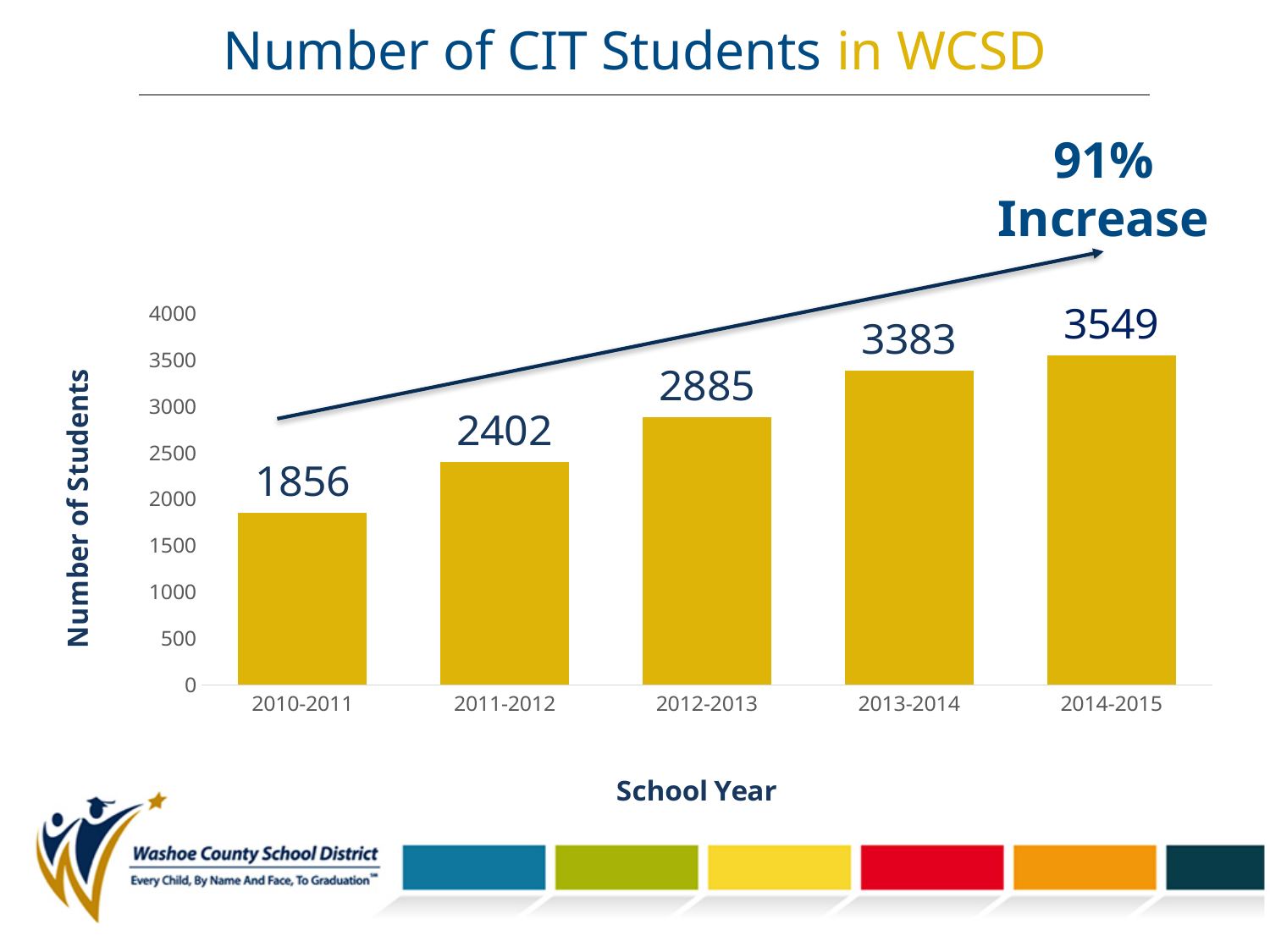
What is the value shown for 2014-2015? 3549 Which school year has the lowest number of CIT students? 2010-2011 What type of chart is shown on the slide? bar chart What is the difference in the number of CIT students between 2014-2015 and 2010-2011? 1693 Do the values rise or fall across the school years from 2010-2011 to 2014-2015? rise Which school year has the highest number of CIT students? 2014-2015 What is the number of CIT students for 2012-2013? 2885 Which has more CIT students, 2011-2012 or 2013-2014? 2013-2014 How many CIT students were there in 2010-2011? 1856 By how much did the number of CIT students increase from 2011-2012 to 2012-2013? 483 How many school years are shown on the chart? 5 Is the value for 2013-2014 greater or less than 3000? greater